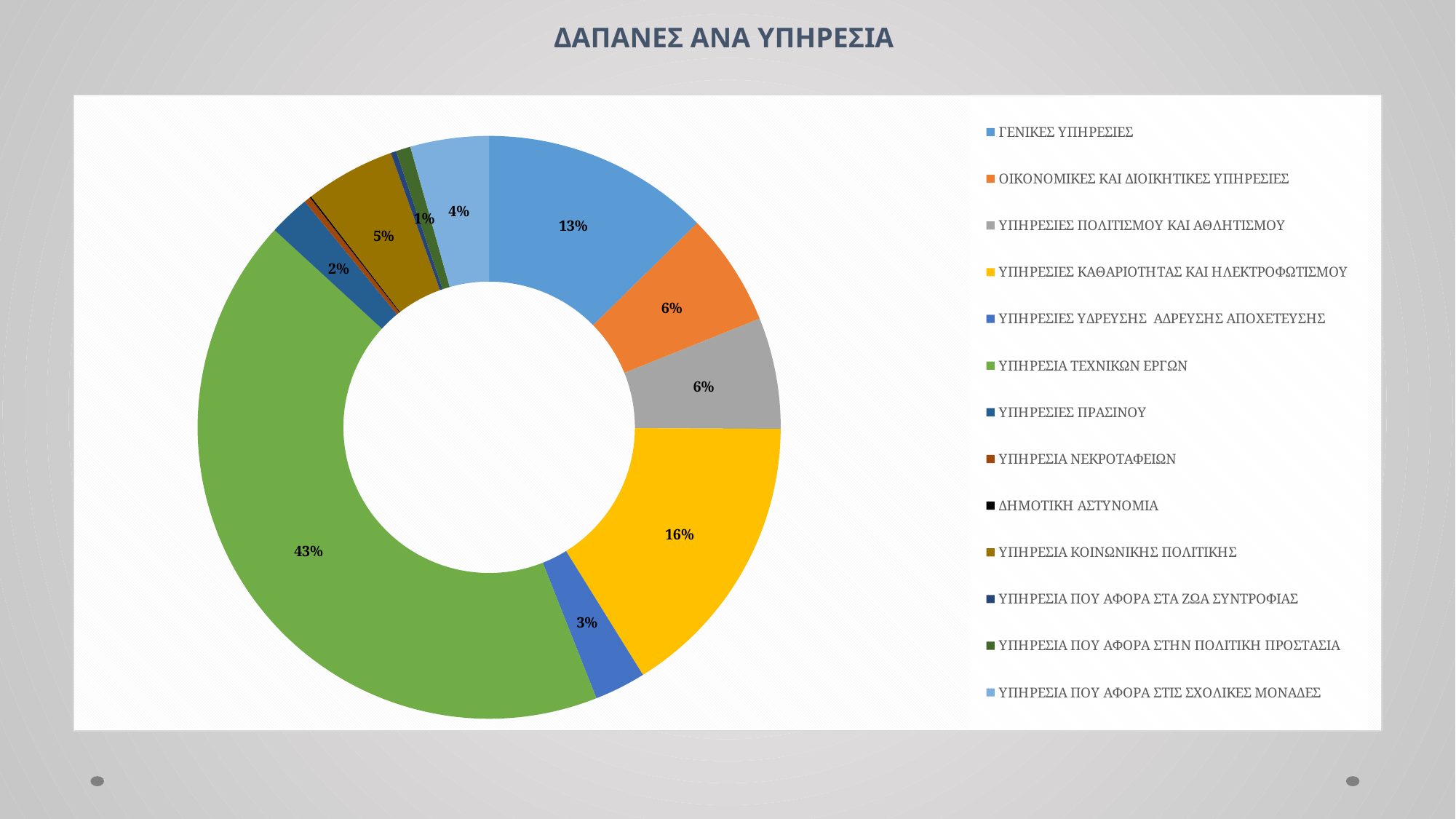
What percentage is shown for ΥΠΗΡΕΣΙΕΣ ΚΑΘΑΡΙΟΤΗΤΑΣ ΚΑΙ ΗΛΕΚΤΡΟΦΩΤΙΣΜΟΥ? 16% Which has a larger share, ΓΕΝΙΚΕΣ ΥΠΗΡΕΣΙΕΣ or ΥΠΗΡΕΣΙΕΣ ΥΔΡΕΥΣΗΣ ΑΔΡΕΥΣΗΣ ΑΠΟΧΕΤΕΥΣΗΣ? ΓΕΝΙΚΕΣ ΥΠΗΡΕΣΙΕΣ How many categories does the legend list? 13 What percentage is shown for ΥΠΗΡΕΣΙΑ ΚΟΙΝΩΝΙΚΗΣ ΠΟΛΙΤΙΚΗΣ? 5% Which category has the largest share of the chart? ΥΠΗΡΕΣΙΑ ΤΕΧΝΙΚΩΝ ΕΡΓΩΝ What is the title of the chart? ΔΑΠΑΝΕΣ ΑΝΑ ΥΠΗΡΕΣΙΑ What percentage is shown for ΓΕΝΙΚΕΣ ΥΠΗΡΕΣΙΕΣ? 13% What is the difference in percentage points between ΥΠΗΡΕΣΙΑ ΤΕΧΝΙΚΩΝ ΕΡΓΩΝ and ΥΠΗΡΕΣΙΕΣ ΚΑΘΑΡΙΟΤΗΤΑΣ ΚΑΙ ΗΛΕΚΤΡΟΦΩΤΙΣΜΟΥ? 27 What colour is the slice for ΥΠΗΡΕΣΙΑ ΤΕΧΝΙΚΩΝ ΕΡΓΩΝ? green What type of chart is shown on the slide? doughnut chart What percentage is shown for ΥΠΗΡΕΣΙΑ ΠΟΥ ΑΦΟΡΑ ΣΤΙΣ ΣΧΟΛΙΚΕΣ ΜΟΝΑΔΕΣ? 4% What percentage is shown for ΥΠΗΡΕΣΙΑ ΤΕΧΝΙΚΩΝ ΕΡΓΩΝ? 43%